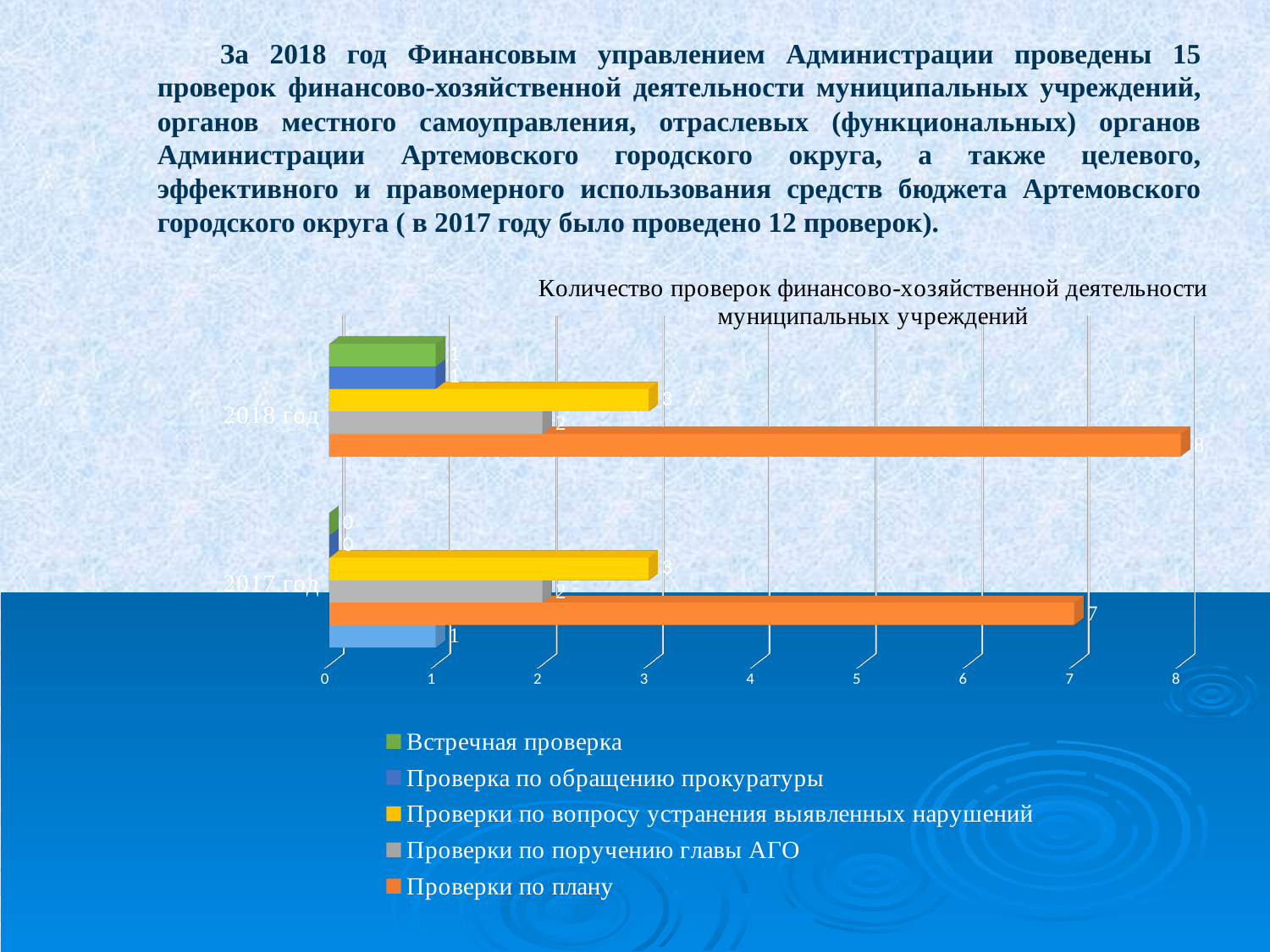
Which series has the highest value for 2018 год? Проверки по плану How many series does the chart legend list? 5 What is the value of 'Проверки по поручению главы АГО' for 2017 год? 2 What kind of chart is shown on the slide? bar chart Which is larger: 'Проверка по обращению прокуратуры' in 2018 год or in 2017 год? 2018 год What is the value of 'Проверки по плану' for 2017 год? 7 What is the value of 'Проверки по плану' for 2018 год? 8 What is the difference between 'Проверки по плану' in 2018 год and in 2017 год? 1 What is the title of the chart? Количество проверок финансово-хозяйственной деятельности муниципальных учреждений How many year categories are shown on the chart's vertical axis? 2 What is the value of 'Встречная проверка' for 2017 год? 0 What is the value of 'Проверки по вопросу устранения выявленных нарушений' for 2018 год? 3